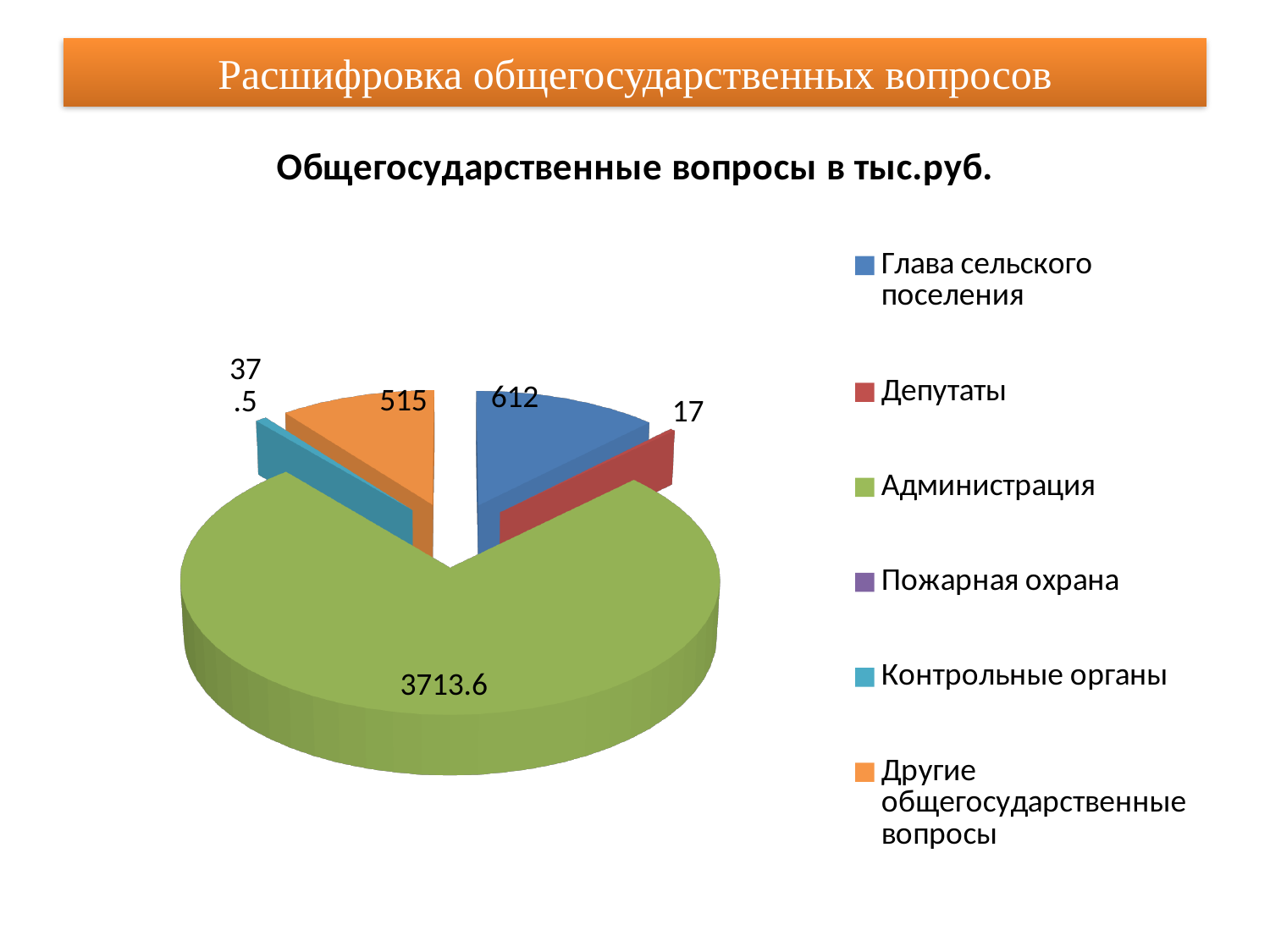
What is the value for Депутаты? 17 How many categories does the legend list? 6 What is the value for Другие общегосударственные вопросы? 515 What is the value for Глава сельского поселения? 612 What is the value for Администрация? 3713.6 What is the difference between the values for Глава сельского поселения and Другие общегосударственные вопросы? 97 What kind of chart is shown on the slide? pie chart What is the value for Контрольные органы? 37.5 Which is larger, the value for Контрольные органы or the value for Депутаты? Контрольные органы What is the title of the chart? Общегосударственные вопросы в тыс.руб. Which category has the smallest printed value on the chart? Депутаты Which category has the largest slice of the pie? Администрация